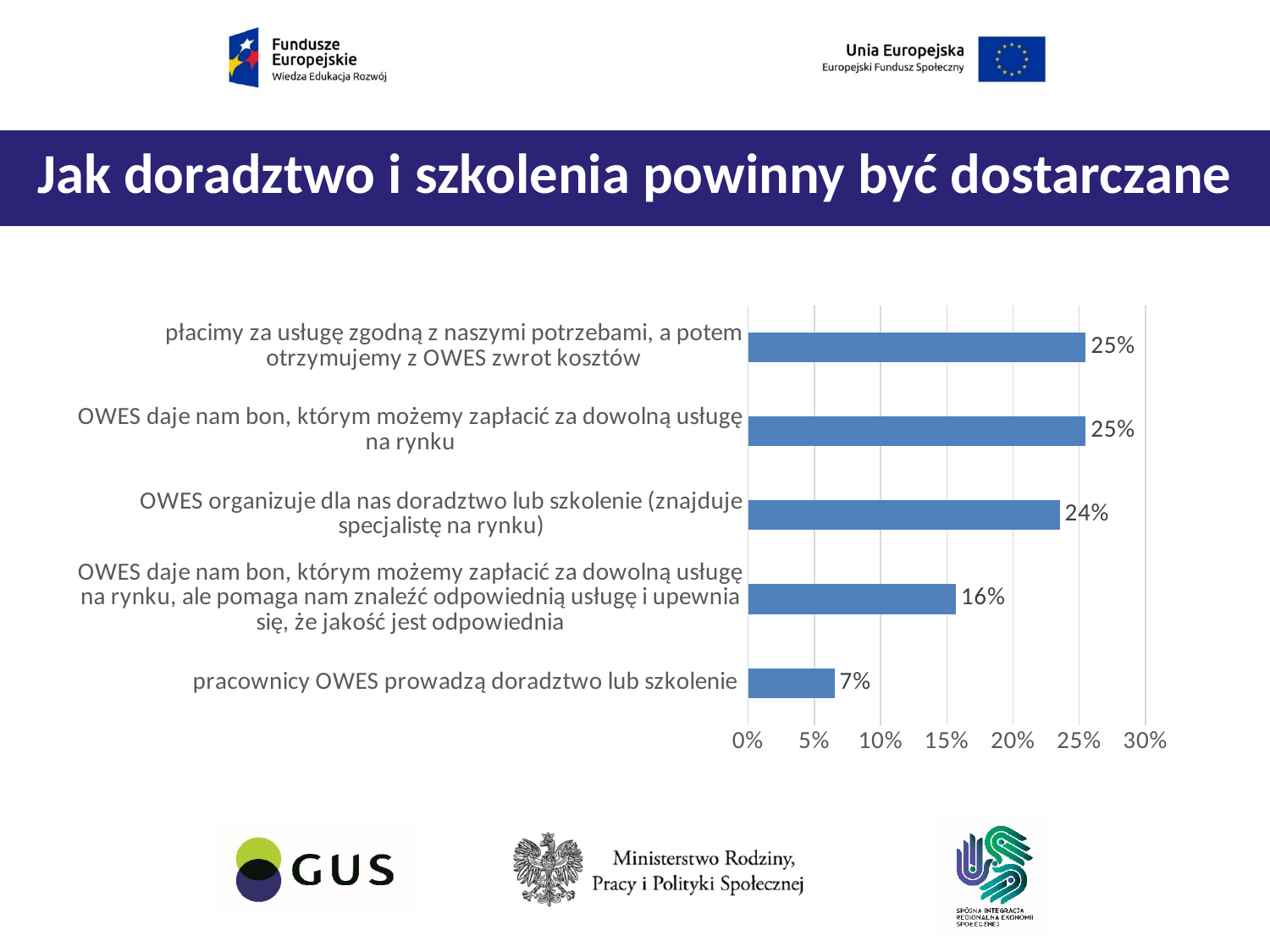
What is the value for "pracownicy OWES prowadzą doradztwo lub szkolenie"? 7% What is the value for "OWES organizuje dla nas doradztwo lub szkolenie (znajduje specjalistę na rynku)"? 24% What is the difference between the value for "OWES organizuje dla nas doradztwo lub szkolenie (znajduje specjalistę na rynku)" and the value for "pracownicy OWES prowadzą doradztwo lub szkolenie"? 17% Which is larger: the value for "OWES organizuje dla nas doradztwo lub szkolenie (znajduje specjalistę na rynku)" or the value for "pracownicy OWES prowadzą doradztwo lub szkolenie"? OWES organizuje dla nas doradztwo lub szkolenie (znajduje specjalistę na rynku) Is the value for "pracownicy OWES prowadzą doradztwo lub szkolenie" greater or less than 10%? less What is the value for "płacimy za usługę zgodną z naszymi potrzebami, a potem otrzymujemy z OWES zwrot kosztów"? 25% What is the difference between the value for "OWES daje nam bon, którym możemy zapłacić za dowolną usługę na rynku" and the value for the bon option where OWES also helps find the service and ensures quality? 9% What is the value for "OWES daje nam bon, którym możemy zapłacić za dowolną usługę na rynku, ale pomaga nam znaleźć odpowiednią usługę i upewnia się, że jakość jest odpowiednia"? 16% What kind of chart is shown on the slide? bar chart How many categories are shown in the chart? 5 Which category has the lowest value? pracownicy OWES prowadzą doradztwo lub szkolenie What is the title of the slide? Jak doradztwo i szkolenia powinny być dostarczane